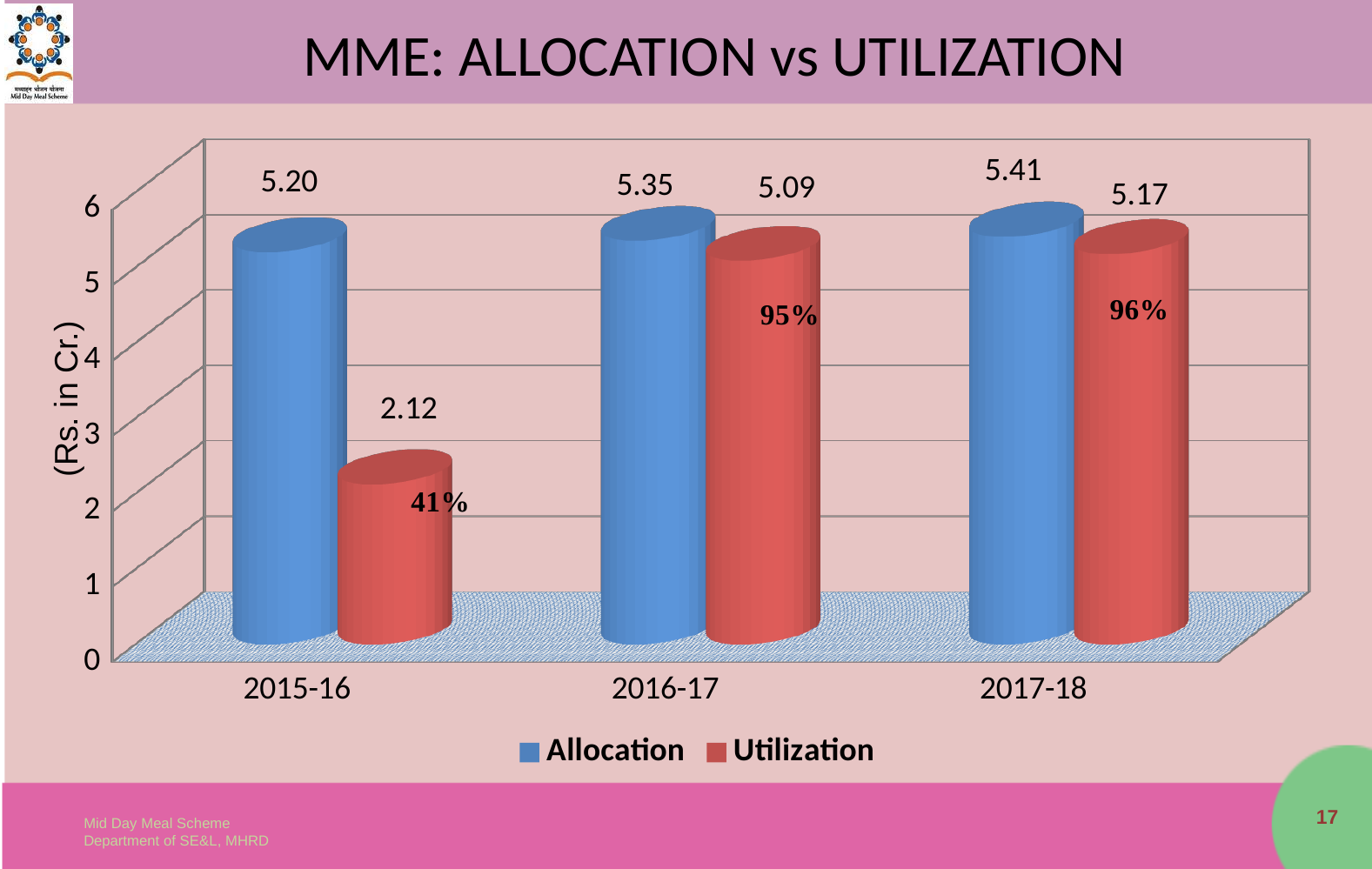
What is the difference between Allocation and Utilization in 2015-16? 3.08 What is the Allocation value for 2017-18? 5.41 How many years are shown on the x axis? 3 What kind of chart is shown on the slide? bar chart What is the Allocation value for 2015-16? 5.20 What is the Utilization value for 2015-16? 2.12 Is the Utilization value for 2015-16 greater or less than 3? less What is the Utilization value for 2016-17? 5.09 Which year has the lowest Utilization value? 2015-16 Which year has the highest Allocation value? 2017-18 What utilization percentage is shown for 2017-18? 96% How many series does the legend list? 2